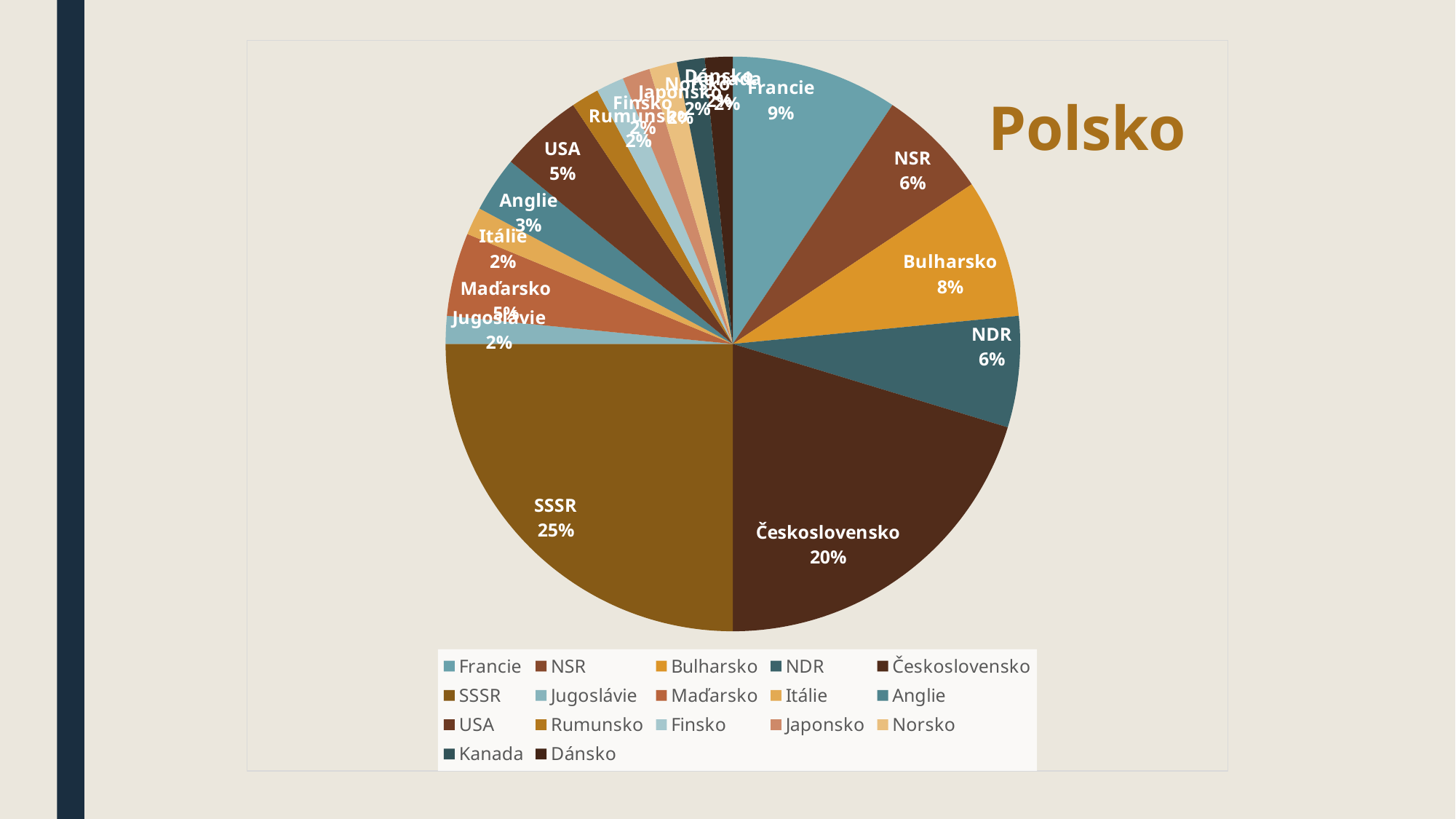
What share of the pie does SSSR have? 25% What is the value shown for Bulharsko? 8% Which is larger, the share for Bulharsko or the share for NDR? Bulharsko What is the value shown for Francie? 9% How many categories does the legend list? 17 Which category has the largest slice of the pie? SSSR What is the value shown for Anglie? 3% What kind of chart is shown on the slide? pie chart What is the title of the chart? Polsko What is the value shown for USA? 5% What share of the pie does Československo have? 20% What is the difference between the shares of SSSR and Československo? 5%